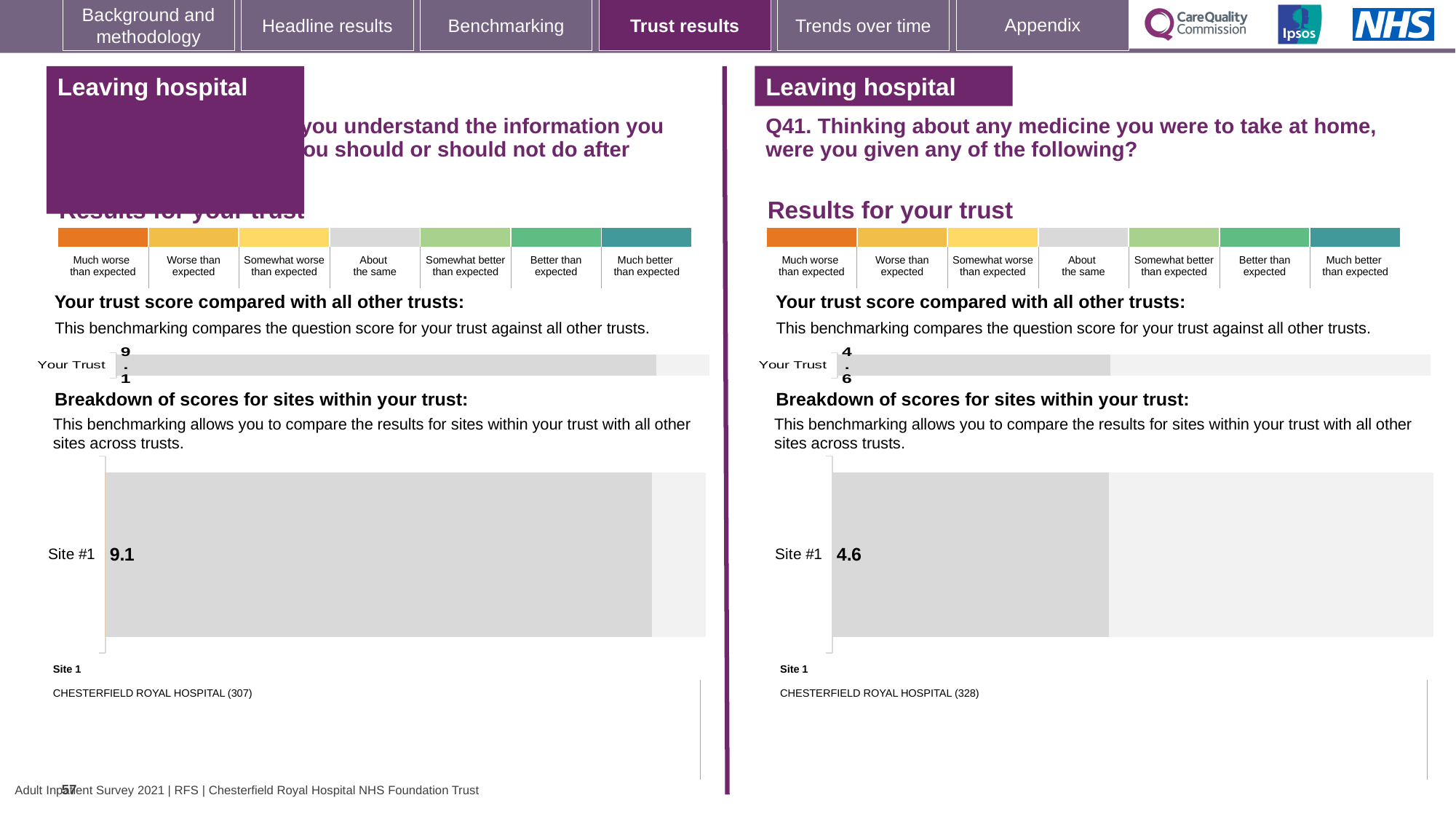
Which is larger: the Site #1 score on the left-hand chart or the Site #1 score on the right-hand (Q41) chart? Left-hand chart (9.1) Is the Site #1 score on the left-hand chart the same as the Your Trust score on the left-hand chart? Yes On the right-hand side of the slide (Q41), what is the score shown for Site #1? 4.6 What is the name of Site 1 listed below the left-hand site breakdown chart? CHESTERFIELD ROYAL HOSPITAL (307) What kind of chart is used for the site breakdown on the right-hand side of the slide (Q41)? Bar chart How many sites are shown in the site breakdown chart on the right-hand side of the slide (Q41)? 1 On the left-hand side of the slide, what is the score shown for Site #1? 9.1 On the left-hand side of the slide, what is the score shown for Your Trust? 9.1 On the right-hand side of the slide (Q41), what is the score shown for Your Trust? 4.6 What is the name of Site 1 listed below the right-hand (Q41) site breakdown chart? CHESTERFIELD ROYAL HOSPITAL (328) What is the difference between the Site #1 score on the left-hand chart and the Site #1 score on the right-hand (Q41) chart? 4.5 How many sites are shown in the site breakdown chart on the left-hand side of the slide? 1